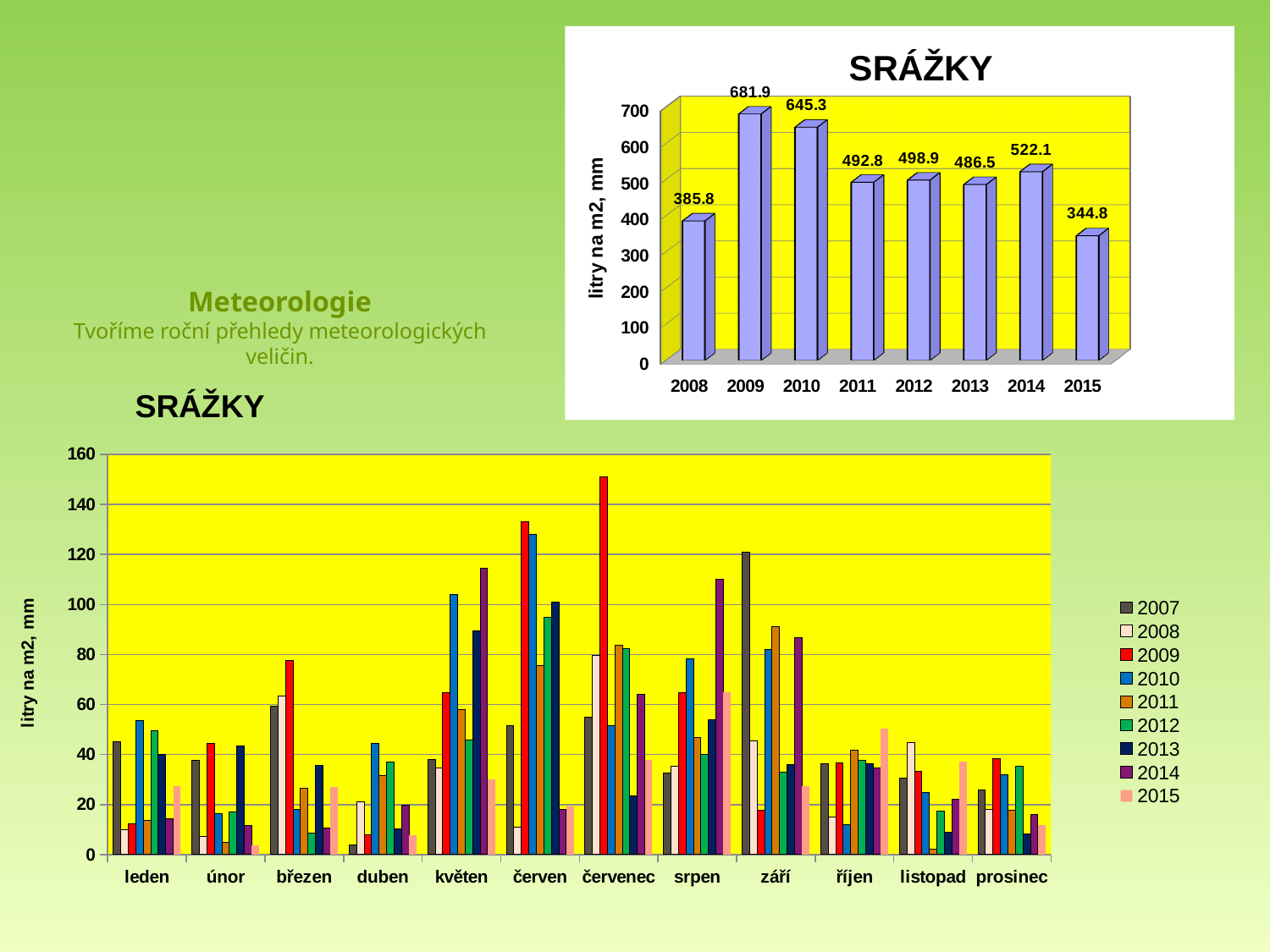
In the top-right SRÁŽKY chart, what is the value for 2009? 681.9 In the bottom monthly SRÁŽKY chart, is the value for 2009 in červenec greater or less than 140? greater In the top-right SRÁŽKY chart, what is the value for 2015? 344.8 In the top-right SRÁŽKY chart, which year has the lowest value? 2015 In the top-right SRÁŽKY chart, what is the label on the vertical axis? litry na m2, mm In the bottom monthly SRÁŽKY chart, how many series does the legend list? 9 What kind of chart is the bottom monthly SRÁŽKY chart? bar chart In the top-right SRÁŽKY chart, how many years are shown on the x axis? 8 In the bottom monthly SRÁŽKY chart, how many months are shown on the x axis? 12 In the top-right SRÁŽKY chart, which year has the highest value? 2009 In the top-right SRÁŽKY chart, which is larger, the value for 2011 or the value for 2014? 2014 In the top-right SRÁŽKY chart, what is the difference between the values for 2009 and 2010? 36.6